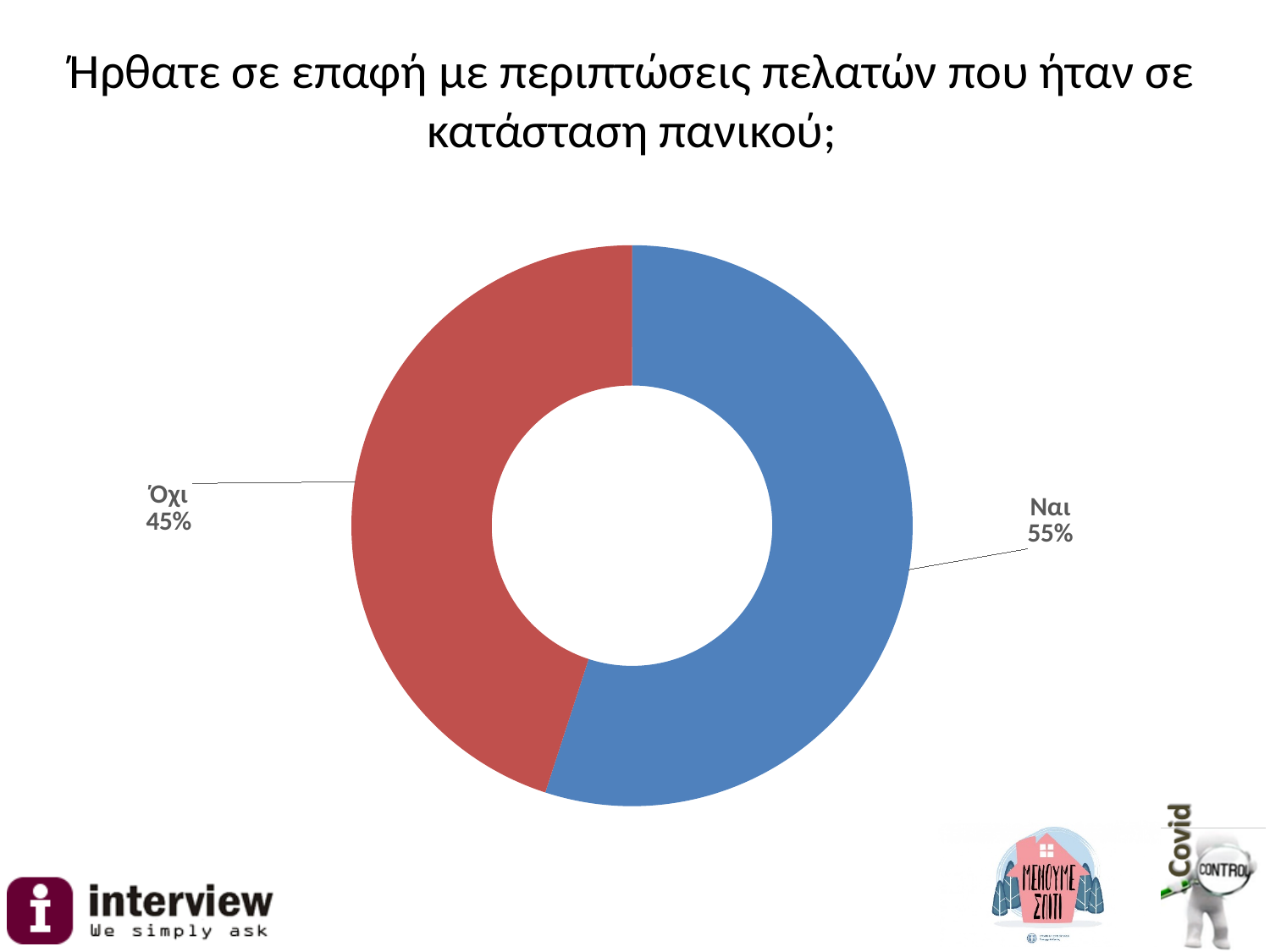
What is the difference in percentage points between Ναι and Όχι? 10 What colour is the Ναι slice? Blue Which category has the largest share of the chart? Ναι What is the share of the Ναι slice in the pie? 55% What percentage of respondents answered Ναι? 55% What percentage of respondents answered Όχι? 45% What colour is the Όχι slice? Red What kind of chart is shown on the slide? Pie chart (doughnut) Which response has the larger share, Ναι or Όχι? Ναι How many categories are shown in the chart? 2 Which category has the smallest share of the chart? Όχι